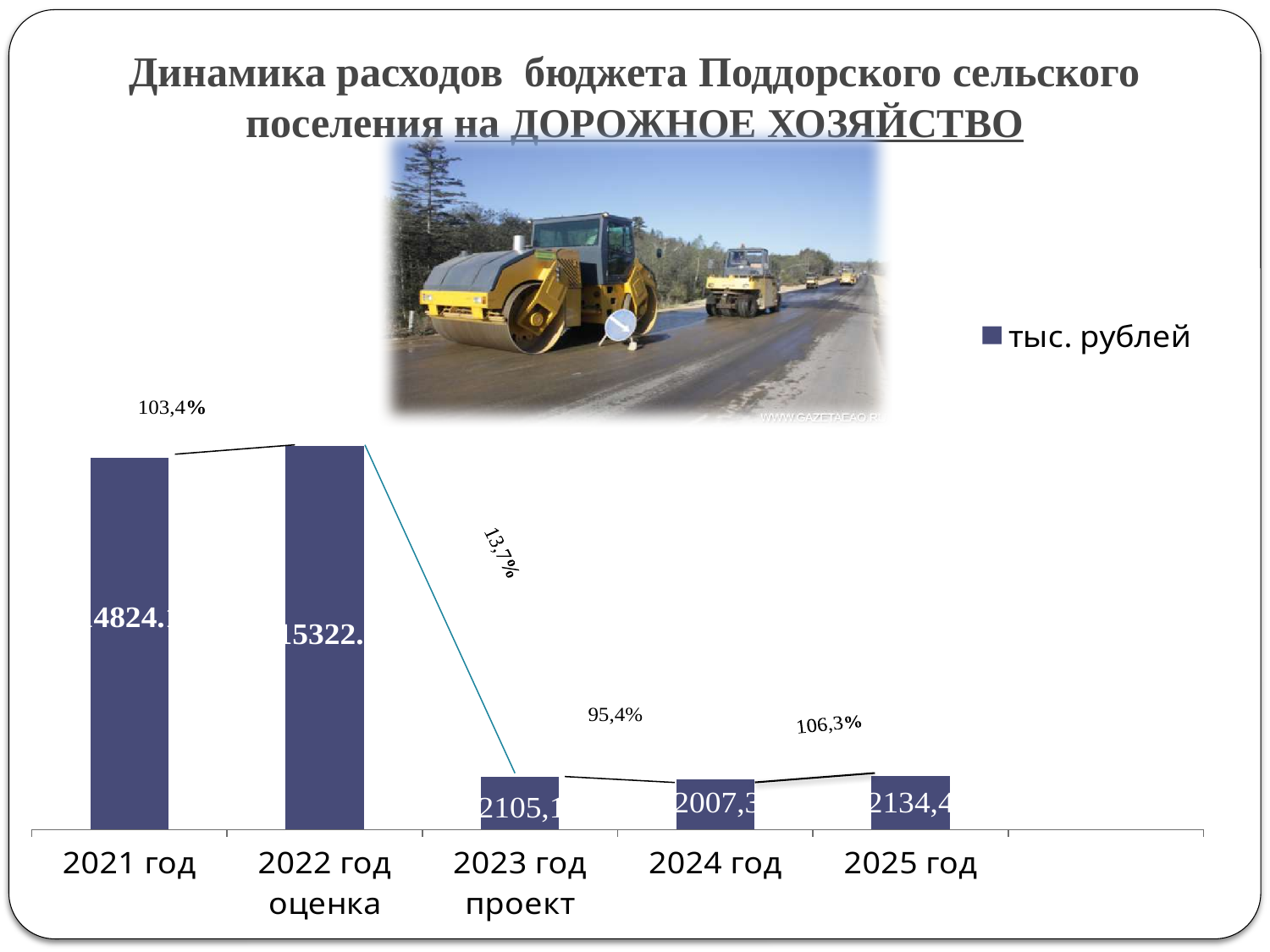
What is the difference between the values for 2023 год проект and 2024 год? 97,8 Which is larger, the value for 2021 год or 2022 год оценка? 2022 год оценка What is the legend entry of the chart? тыс. рублей Which year has the lowest value? 2024 год What is the value for 2024 год? 2007,3 How many years are shown on the x axis? 5 What kind of chart is shown? bar chart What is the value for 2023 год проект? 2105,1 Which year has the highest value? 2022 год оценка What is the difference between the values for 2025 год and 2024 год? 127,1 How many series does the legend list? 1 What is the value for 2025 год? 2134,4